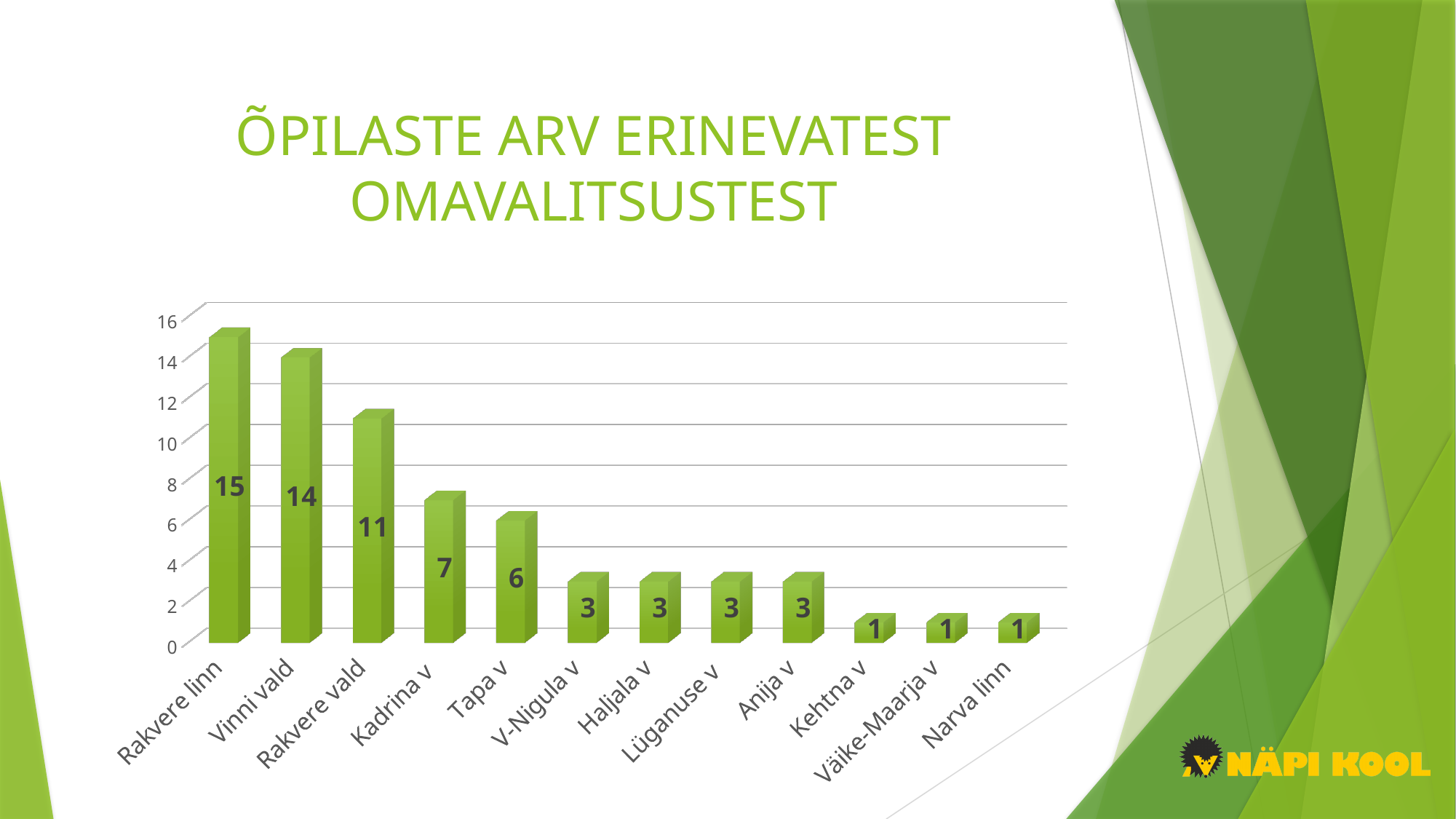
Which category has the highest value? Rakvere linn What is the title of the chart on the slide? ÕPILASTE ARV ERINEVATEST OMAVALITSUSTEST What is the value for Kehtna v? 1 What is the value for Rakvere vald? 11 Do the values rise or fall from left to right along the x axis? fall What is the value for Rakvere linn? 15 What is the value for Tapa v? 6 Is the value for Rakvere vald greater or less than 10? greater What is the difference between the values for Vinni vald and Kadrina v? 7 What kind of chart is shown on the slide? bar chart How many categories are shown on the x axis? 12 Which is larger, the value for Kadrina v or the value for Tapa v? Kadrina v